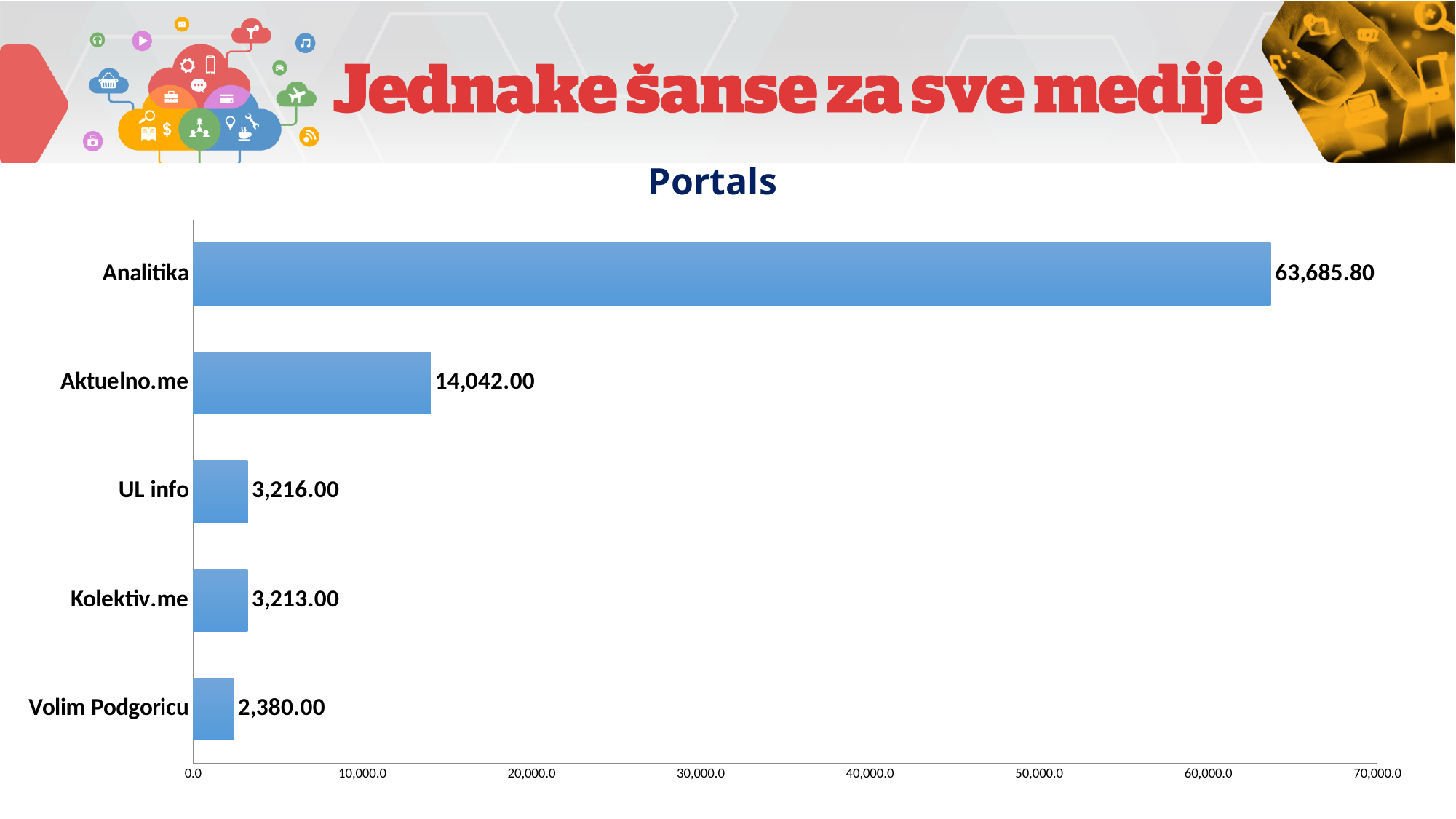
What is the title of the chart? Portals Which portal has the lowest value? Volim Podgoricu Which portal has the highest value? Analitika How many portals are shown in the chart? 5 Is the value for Aktuelno.me greater or less than 10,000.0? greater What is the value for Aktuelno.me? 14,042.00 What is the difference between the values for Analitika and Aktuelno.me? 49,643.80 Which is larger, the value for Aktuelno.me or the value for UL info? Aktuelno.me What is the value for Analitika? 63,685.80 What kind of chart is shown on the slide? bar chart What is the value for Volim Podgoricu? 2,380.00 What is the difference between the values for UL info and Kolektiv.me? 3.00